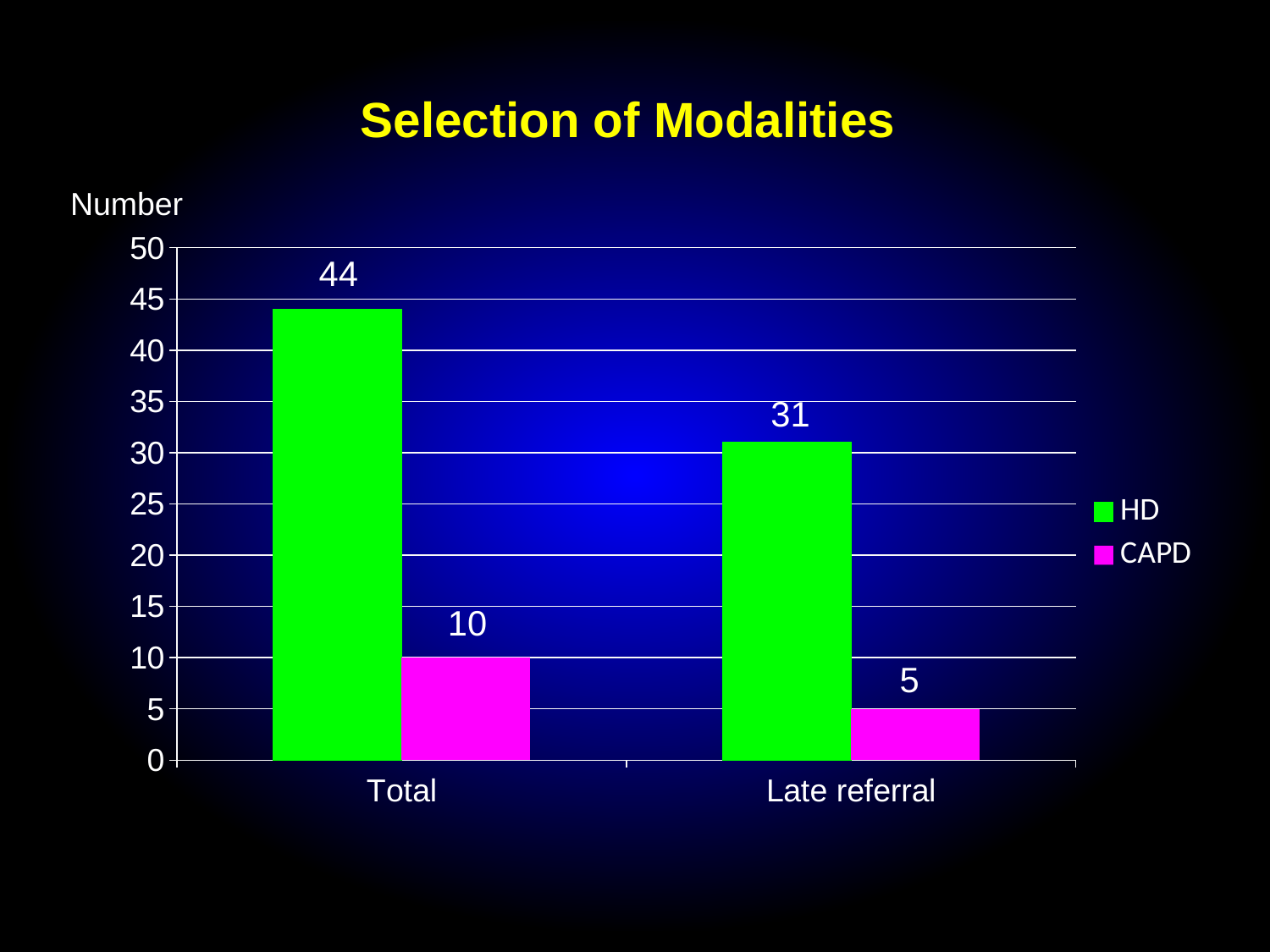
Which category has the lowest CAPD value? Late referral Which is larger for Late referral, HD or CAPD? HD What kind of chart is shown on the slide? Bar chart What is the difference between the HD values for Total and Late referral? 13 Which category has the highest HD value? Total What is the CAPD value for the Late referral category? 5 What is the CAPD value for the Total category? 10 What is the HD value for the Late referral category? 31 What is the difference between the HD and CAPD values for the Total category? 34 How many series does the legend list? 2 How many categories are shown on the x axis? 2 What is the HD value for the Total category? 44